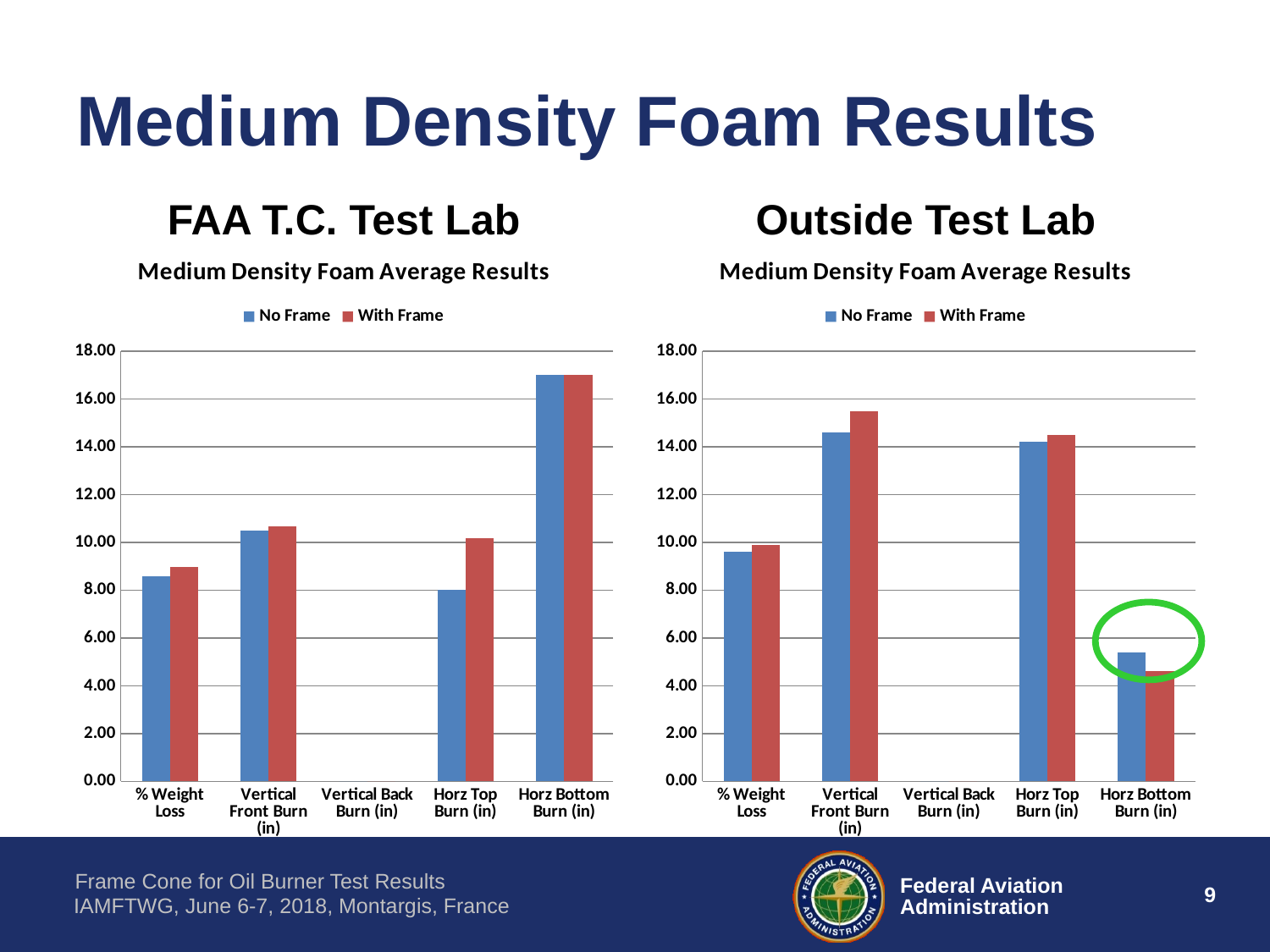
What kind of chart is the FAA T.C. Test Lab chart? bar chart How many categories are shown on the x axis of the FAA T.C. Test Lab chart? 5 In the Outside Test Lab chart, is the No Frame value for Horz Bottom Burn (in) greater or less than 6.00? less In the Outside Test Lab chart, which category has the highest With Frame value? Vertical Front Burn (in) In the Outside Test Lab chart, for Horz Bottom Burn (in), which is larger: No Frame or With Frame? No Frame In the FAA T.C. Test Lab chart, is the No Frame value for Horz Bottom Burn (in) greater or less than 16.00? greater How many series does the legend of the Outside Test Lab chart list? 2 In the FAA T.C. Test Lab chart, is the No Frame value for Horz Top Burn (in) greater or less than 10.00? less In the FAA T.C. Test Lab chart, which category has the highest No Frame value? Horz Bottom Burn (in) In the Outside Test Lab chart, which category is circled in green? Horz Bottom Burn (in) In the FAA T.C. Test Lab chart, for Horz Top Burn (in), which is larger: No Frame or With Frame? With Frame